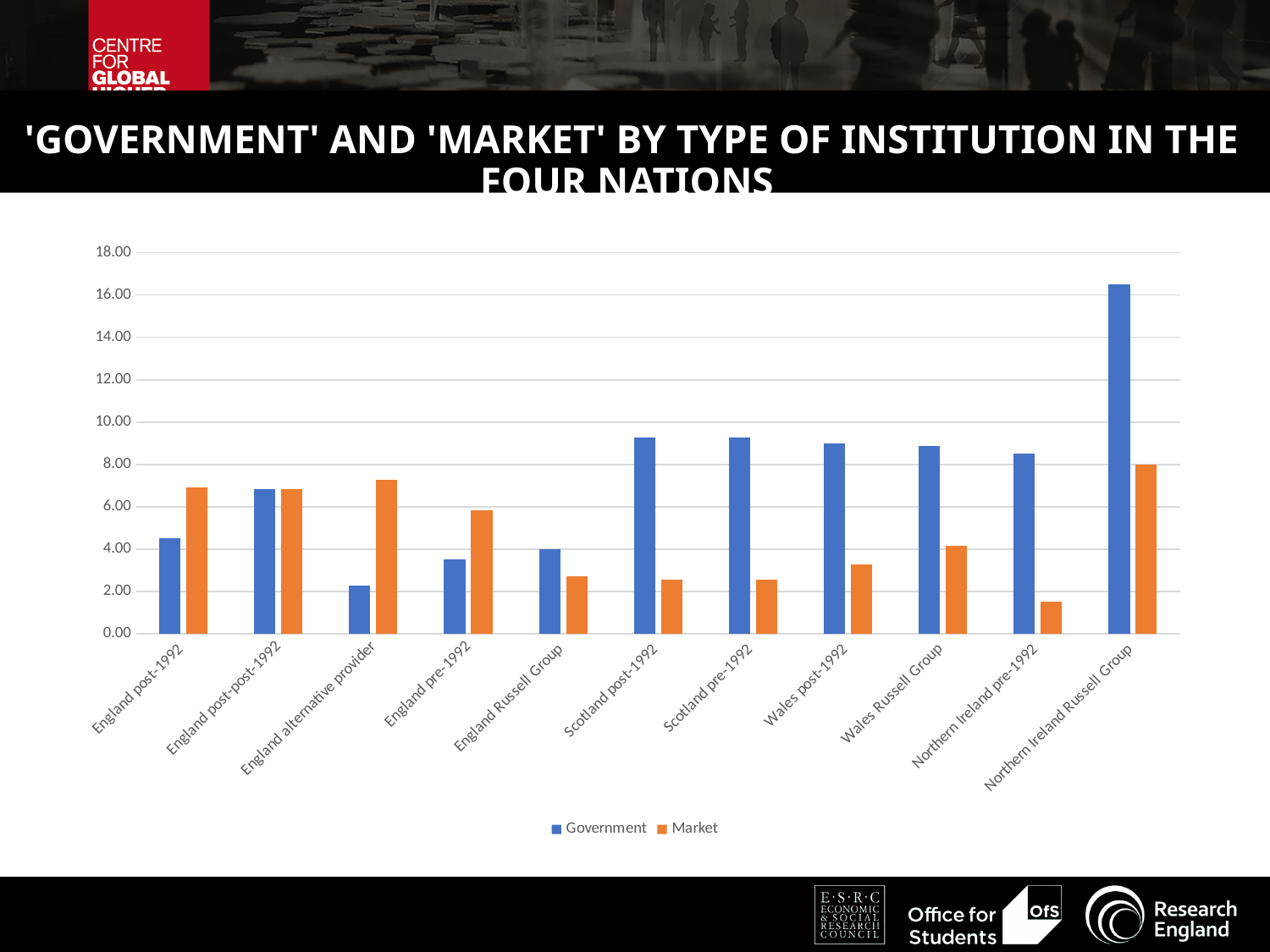
Which category has the highest Government value? Northern Ireland Russell Group Is the Government value for Scotland post-1992 greater or less than 8.00? greater What type of chart is shown on the slide? bar chart For Wales Russell Group, which is larger: the Government value or the Market value? Government How many series does the legend list? 2 For England post-1992, which is larger: the Government value or the Market value? Market How many institution types (categories) are shown on the x axis? 11 Is the Market value for England alternative provider greater or less than 6.00? greater Which category has the lowest Market value? Northern Ireland pre-1992 Which category has the lowest Government value? England alternative provider Is the Government value for Northern Ireland Russell Group greater or less than 14.00? greater